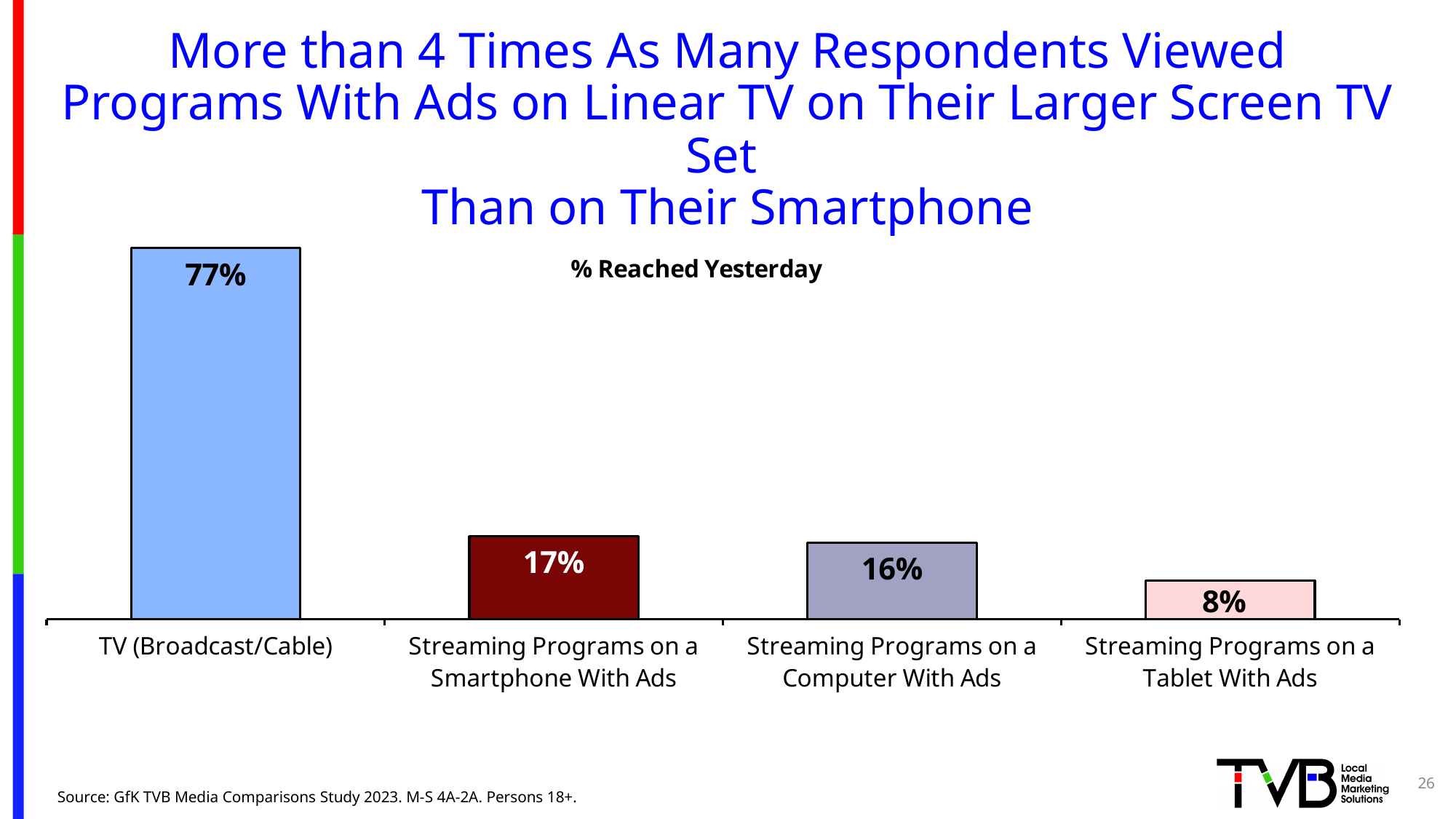
What is the title shown above the chart's bars? % Reached Yesterday What is the value for Streaming Programs on a Tablet With Ads? 8% Which is larger: the value for Streaming Programs on a Smartphone With Ads or Streaming Programs on a Tablet With Ads? Streaming Programs on a Smartphone With Ads What kind of chart is shown on the slide? Bar chart What is the value for Streaming Programs on a Computer With Ads? 16% What is the value for Streaming Programs on a Smartphone With Ads? 17% What is the difference between the values for Streaming Programs on a Computer With Ads and Streaming Programs on a Tablet With Ads? 8% What is the % Reached Yesterday value for TV (Broadcast/Cable)? 77% What is the difference between the values for TV (Broadcast/Cable) and Streaming Programs on a Smartphone With Ads? 60% How many categories are shown in the chart? 4 Which category has the highest % Reached Yesterday? TV (Broadcast/Cable) Which category has the lowest % Reached Yesterday? Streaming Programs on a Tablet With Ads